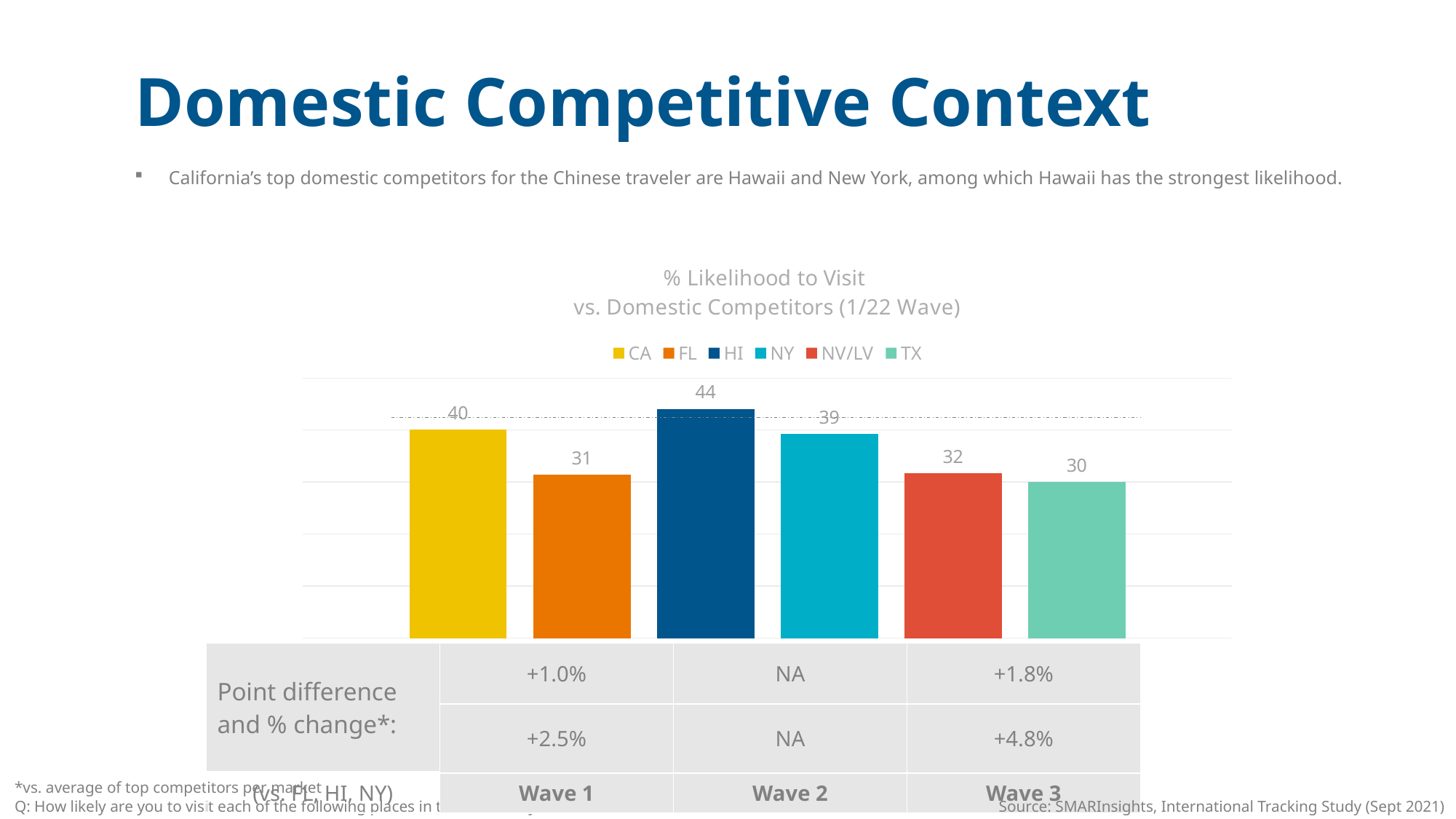
Which destination has the highest % likelihood to visit? HI What is the value for NY in the chart? 39 What is the value for CA in the chart? 40 Which destination has the lowest % likelihood to visit? TX What is the value for TX in the chart? 30 Which is larger, the value for CA or the value for NY? CA What is the difference between the values for NV/LV and FL? 1 How many destinations are plotted in the chart? 6 What kind of chart is shown on the slide? Bar chart What is the value for HI in the chart? 44 How many series does the legend list? 6 What is the difference between the values for HI and CA? 4